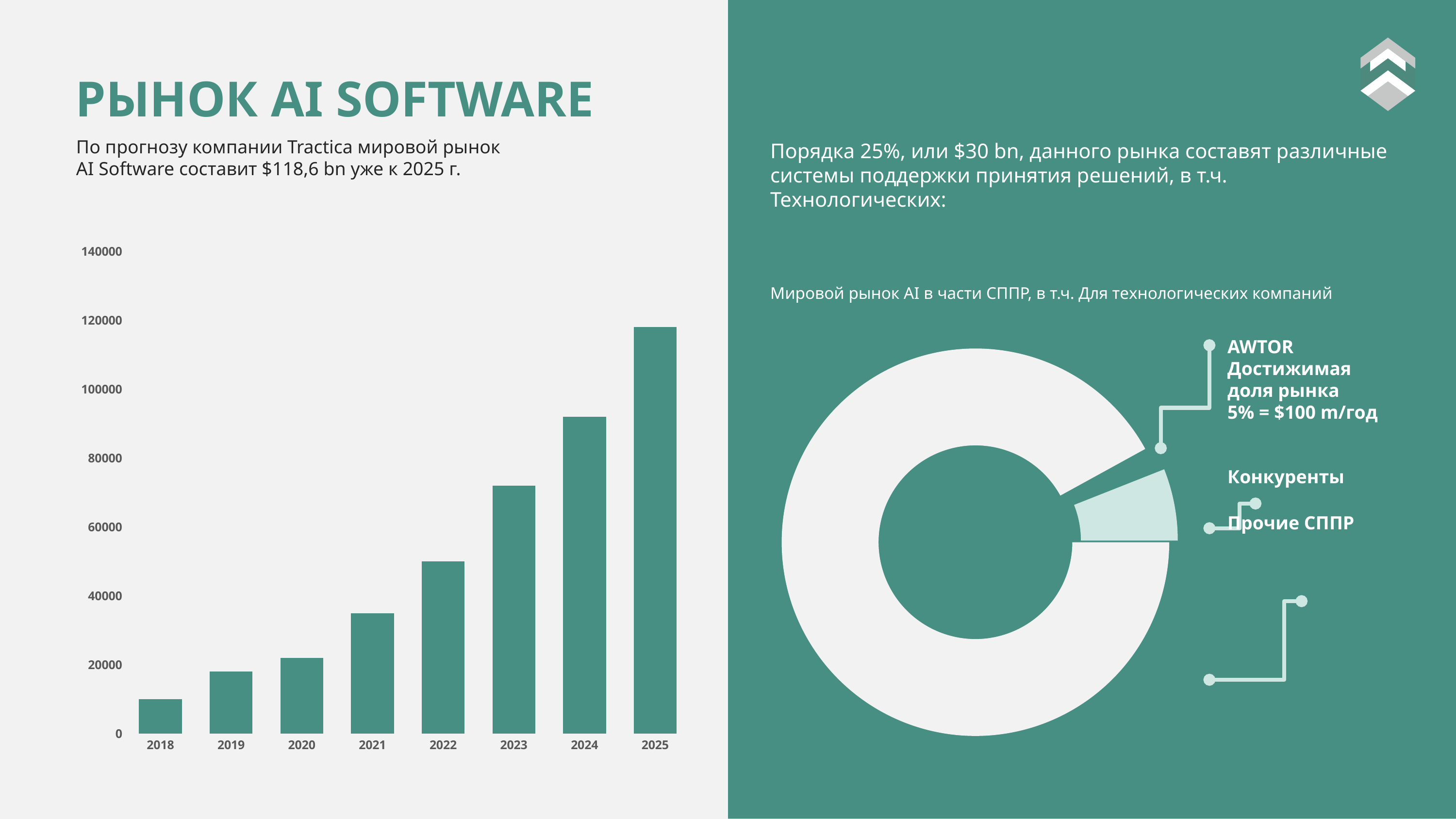
In the bar chart on the left, is the value for 2025 greater or less than 100000? greater In the bar chart on the left, how many years are shown on the x axis? 8 In the bar chart on the left, which year has the larger value, 2021 or 2023? 2023 In the bar chart on the left, is the value for 2024 greater or less than 80000? greater In the bar chart on the left, which year has the highest value? 2025 In the bar chart on the left, do the values rise or fall from 2018 to 2025? rise What kind of chart is shown on the right side of the slide? donut (pie) chart In the bar chart on the left, is the value for 2023 greater or less than 60000? greater In the bar chart on the left, which year has the lowest value? 2018 What kind of chart is shown on the left side of the slide? bar chart What is the title of the chart on the right side of the slide? Мировой рынок AI в части СППР, в т.ч. Для технологических компаний